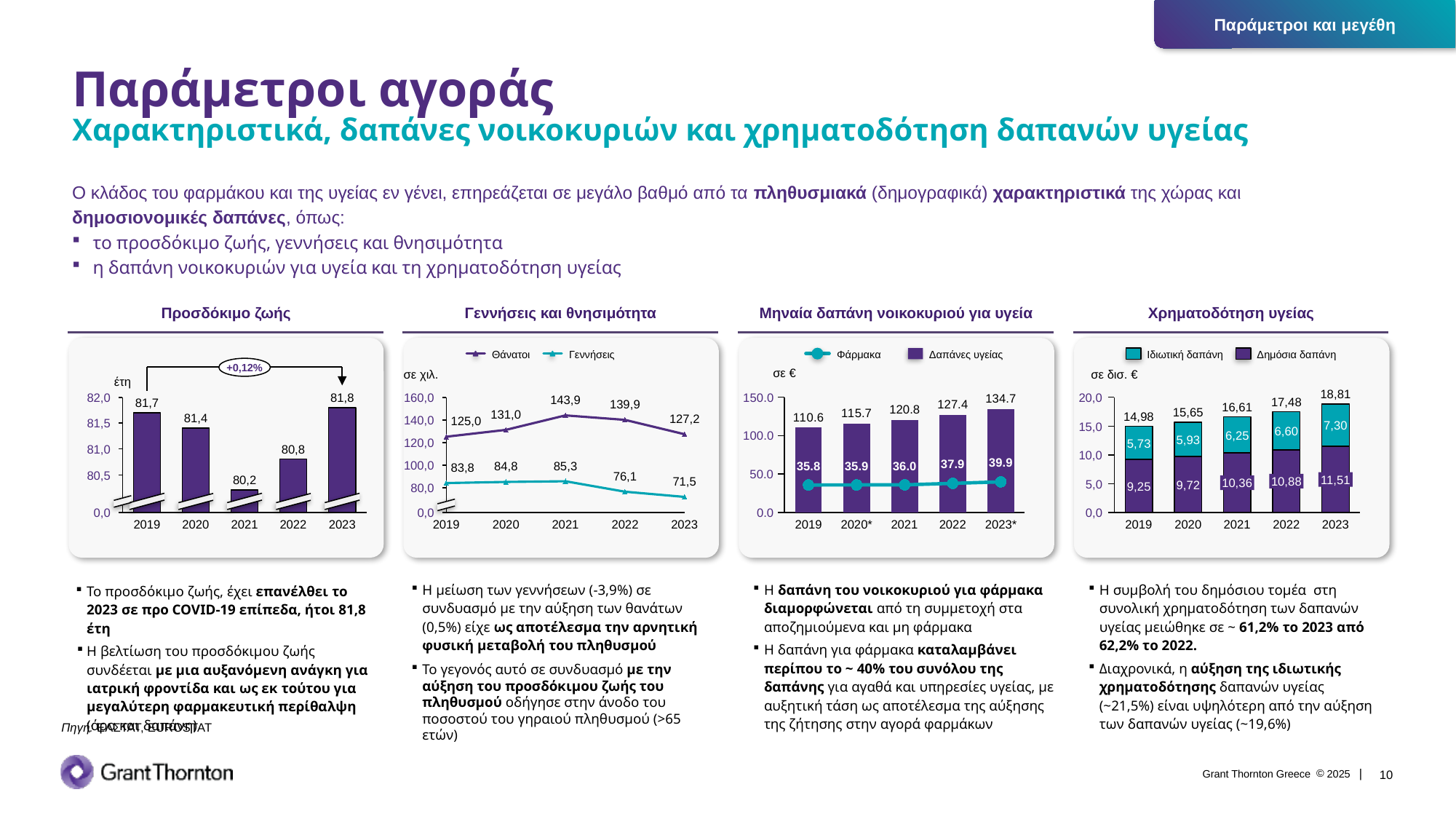
In the 'Μηνιαία δαπάνη νοικοκυριού για υγεία' chart, which year has the highest value for Δαπάνες υγείας? 2023* In the 'Γεννήσεις και θνησιμότητα' chart, do the Γεννήσεις values rise or fall from 2021 to 2023? Fall In the 'Χρηματοδότηση υγείας' chart, what is the total of the stacked bar for 2023? 18,81 In the 'Χρηματοδότηση υγείας' chart, what is the value for Δημόσια δαπάνη in 2021? 10,36 In the 'Γεννήσεις και θνησιμότητα' chart, what is the difference between Θάνατοι and Γεννήσεις in 2023? 55,7 In the 'Χρηματοδότηση υγείας' chart, which is larger in 2019: Ιδιωτική δαπάνη or Δημόσια δαπάνη? Δημόσια δαπάνη In the 'Γεννήσεις και θνησιμότητα' chart, how many series does the legend list? 2 In the 'Γεννήσεις και θνησιμότητα' chart, what is the value for Θάνατοι in 2021? 143,9 What kind of chart is the 'Προσδόκιμο ζωής' chart? Bar chart In the 'Προσδόκιμο ζωής' chart, what is the value for 2023? 81,8 In the 'Μηνιαία δαπάνη νοικοκυριού για υγεία' chart, what is the value for Φάρμακα in 2023*? 39.9 In the 'Προσδόκιμο ζωής' chart, which year has the lowest value? 2021